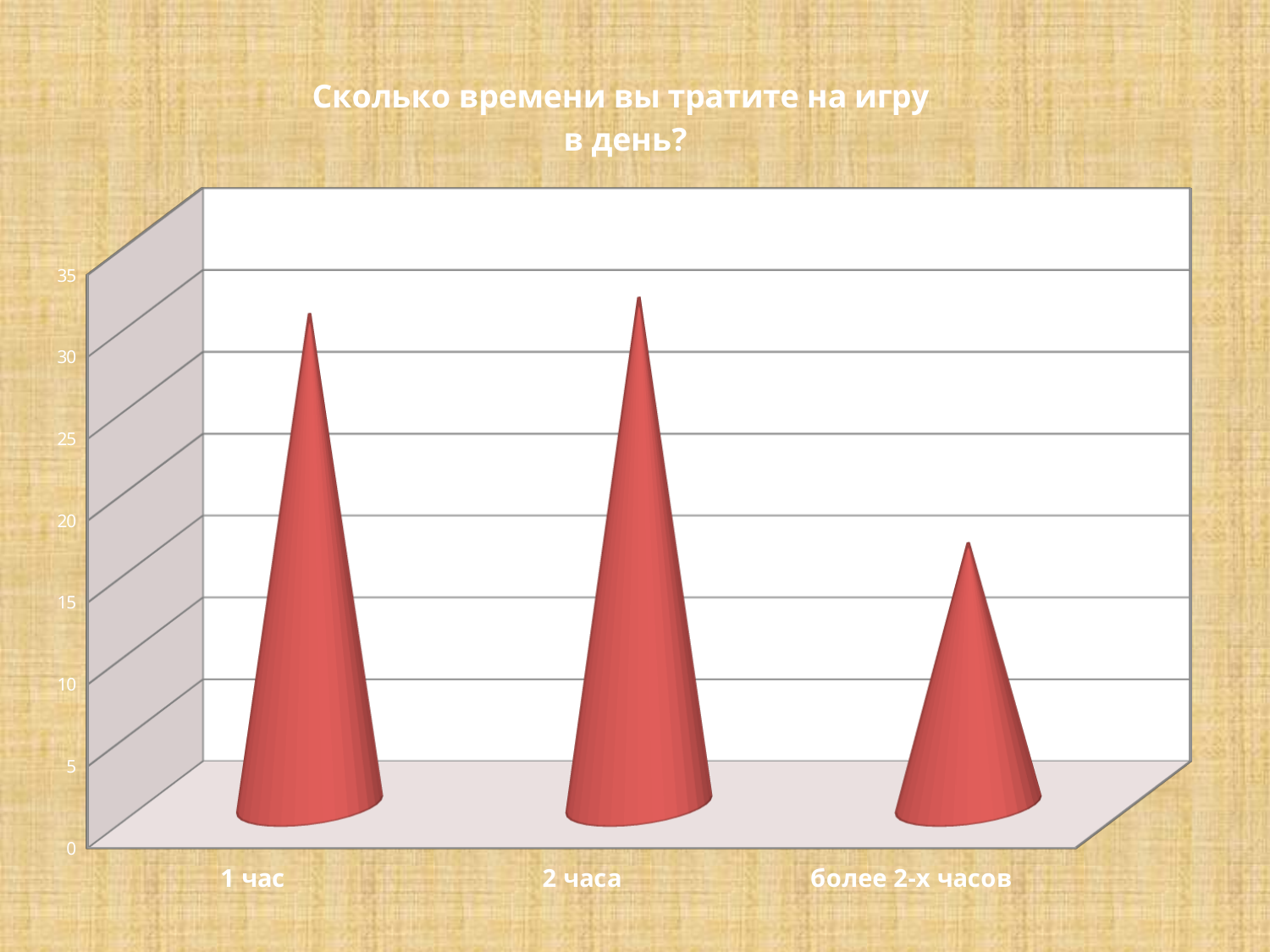
What is the title of the chart? Сколько времени вы тратите на игру в день? Which is larger: the value for "2 часа" or the value for "более 2-х часов"? 2 часа Is the value for "более 2-х часов" greater or less than 10? greater What kind of chart is shown on the slide? bar chart How many categories are shown on the x axis of the chart? 3 Is the value for "1 час" greater or less than 20? greater Which is larger: the value for "1 час" or the value for "более 2-х часов"? 1 час What is the highest value labelled on the vertical axis of the chart? 35 What colour are the bars in the chart? red Is the value for "2 часа" greater or less than 25? greater Which category has the lowest value in the chart? более 2-х часов